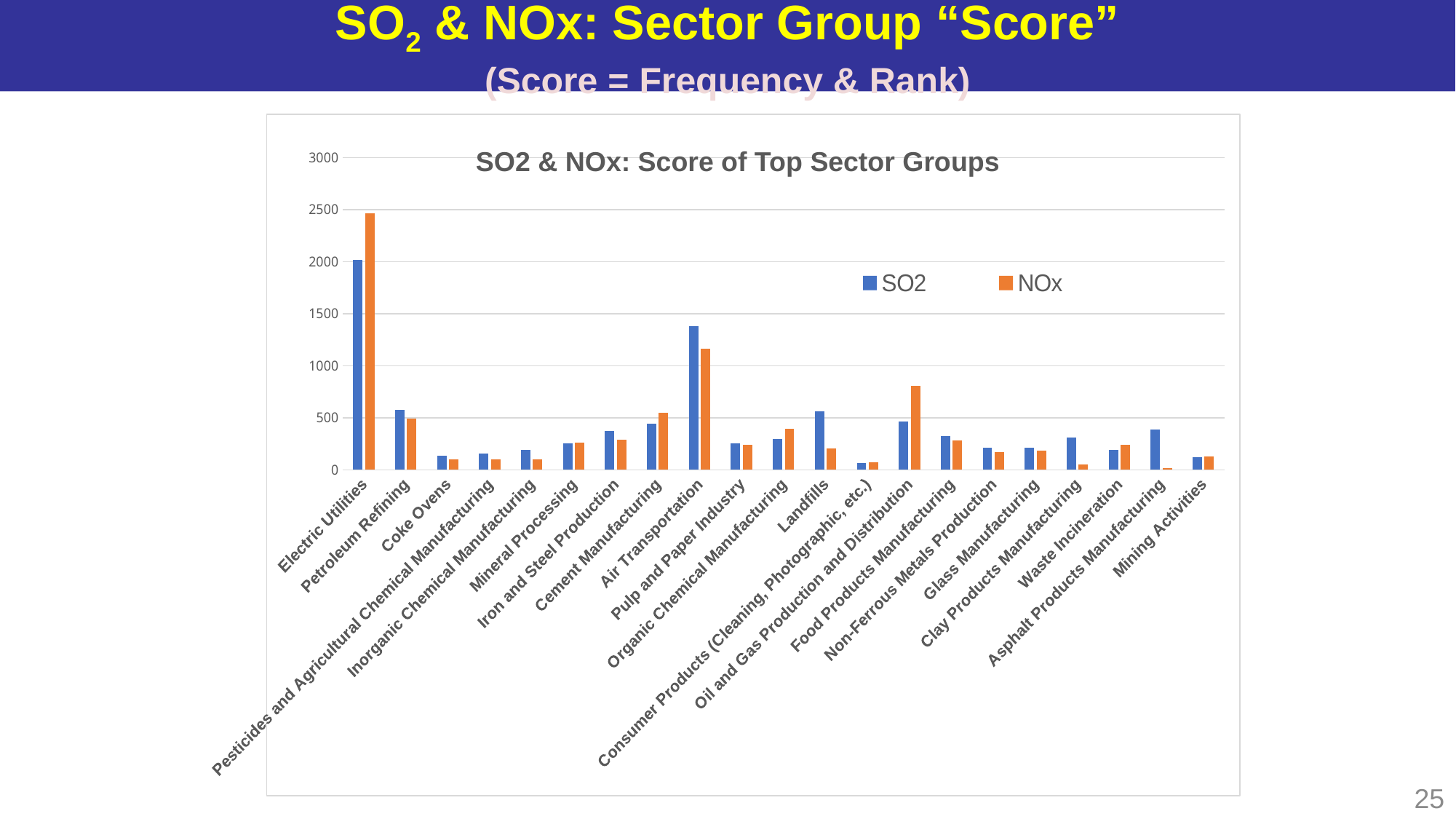
What type of chart is shown on the slide? Bar chart Is the SO2 score for Air Transportation greater or less than 1000? greater Which sector group has the highest SO2 score? Electric Utilities Which sector group has the highest NOx score? Electric Utilities Is the NOx score for Landfills greater or less than 500? less For Oil and Gas Production and Distribution, which is larger, the SO2 score or the NOx score? NOx How many series does the legend list? 2 Is the NOx score for Oil and Gas Production and Distribution greater or less than 500? greater What is the title of the chart? SO2 & NOx: Score of Top Sector Groups Which sector group has the lowest NOx score? Asphalt Products Manufacturing How many sector groups are shown on the x axis? 21